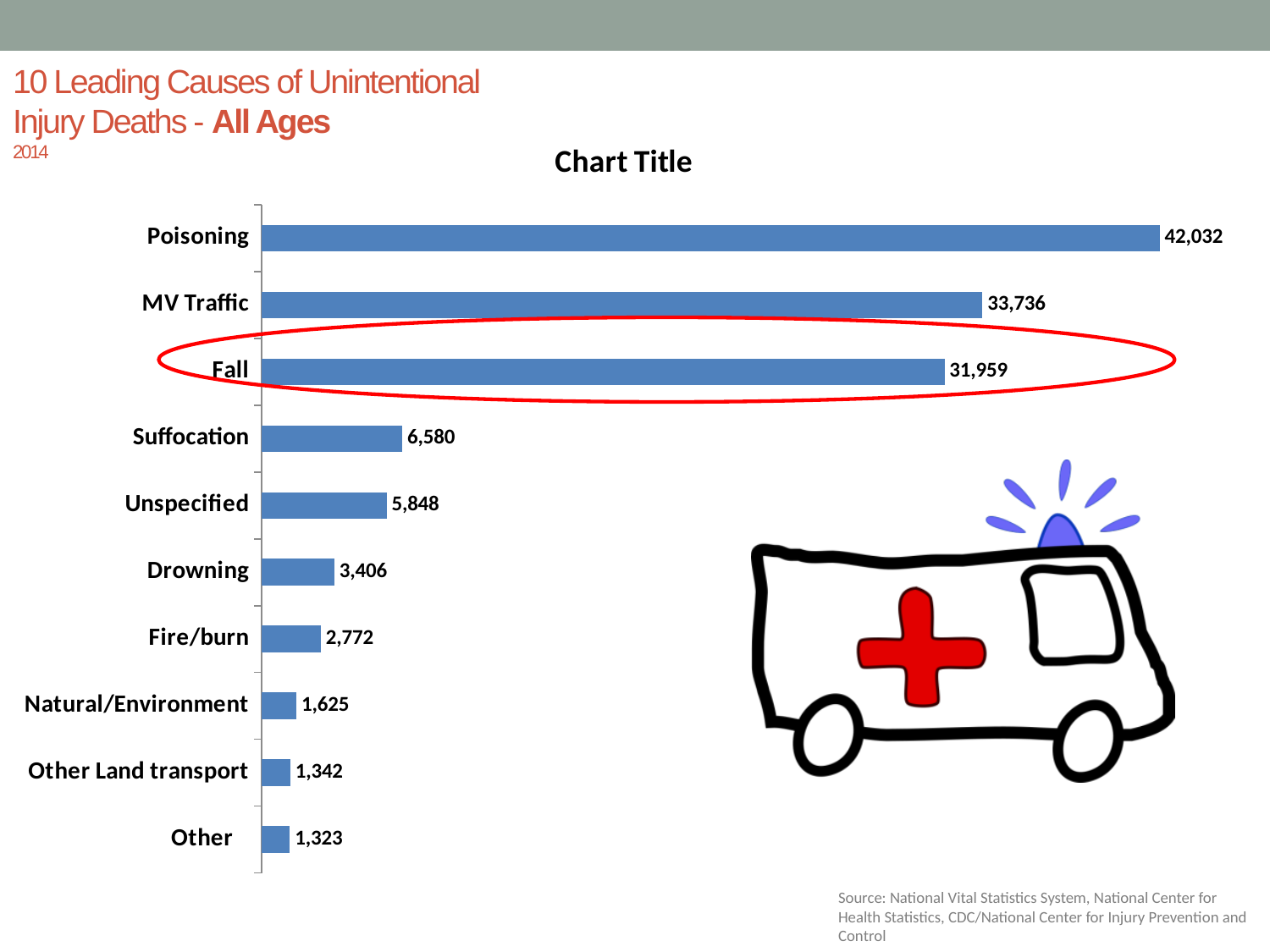
Which category has the highest value? Poisoning Which category has the lowest value? Other How many categories are shown in the chart? 10 What is the difference between the values for Poisoning and MV Traffic? 8,296 What is the value for Drowning? 3,406 What is the difference between the values for Suffocation and Unspecified? 732 Which category is circled in red on the chart? Fall What is the value for Other Land transport? 1,342 Which is larger, the value for Fire/burn or the value for Natural/Environment? Fire/burn What kind of chart is shown on the slide? Bar chart What is the value for Fall? 31,959 What is the value for Poisoning? 42,032